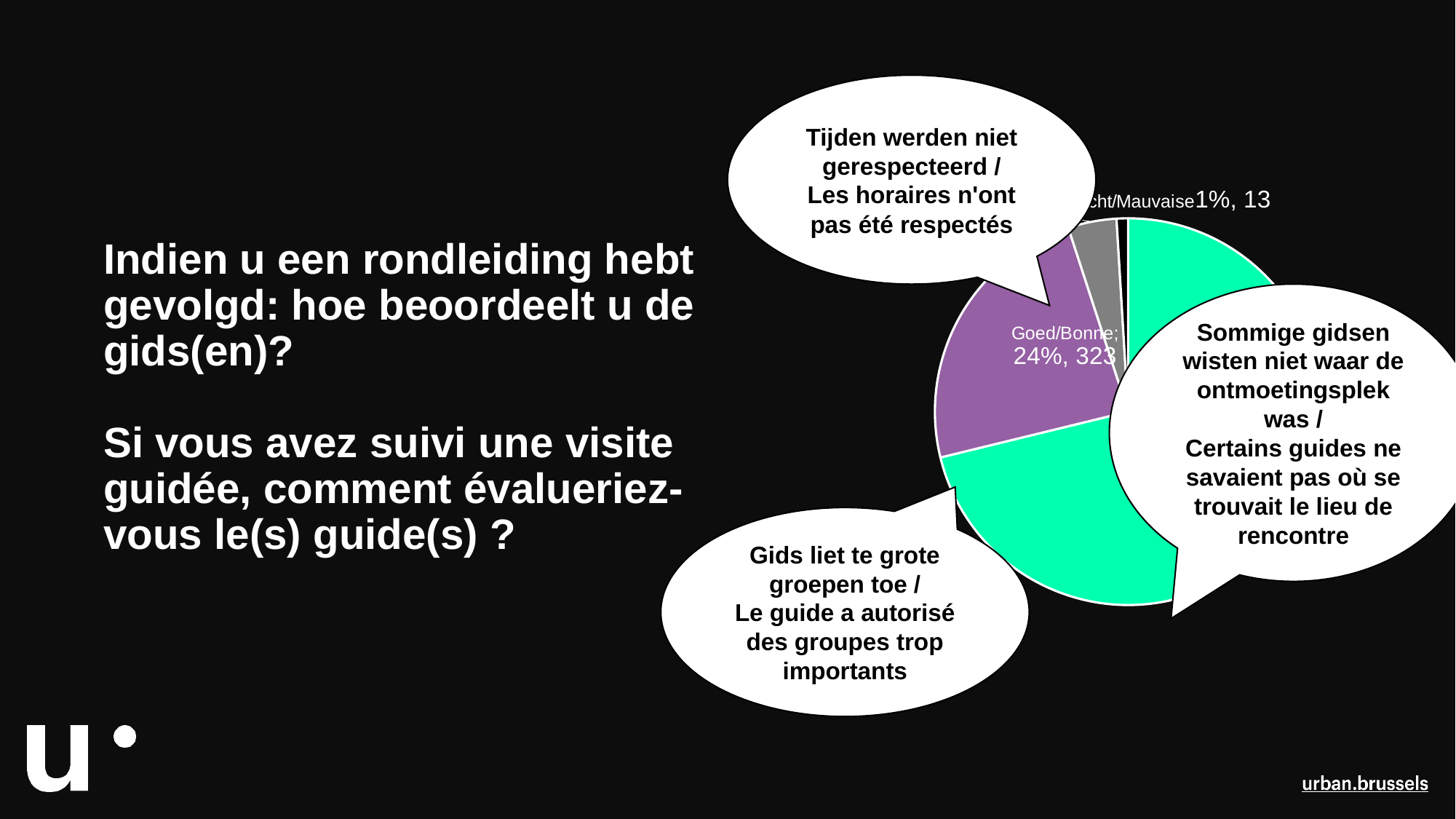
What share of the pie does the Goed/Bonne slice represent? 24% What percentage is printed for the Mauvaise slice? 1% What count is printed for the Goed/Bonne slice? 323 What count is printed for the Mauvaise slice? 13 What colour is the largest slice of the pie? green What is the difference between the counts for Goed/Bonne (323) and Mauvaise (13)? 310 What kind of chart is shown on the slide? pie chart What colour is the Goed/Bonne slice? purple Which slice has the larger count, Goed/Bonne or Mauvaise? Goed/Bonne